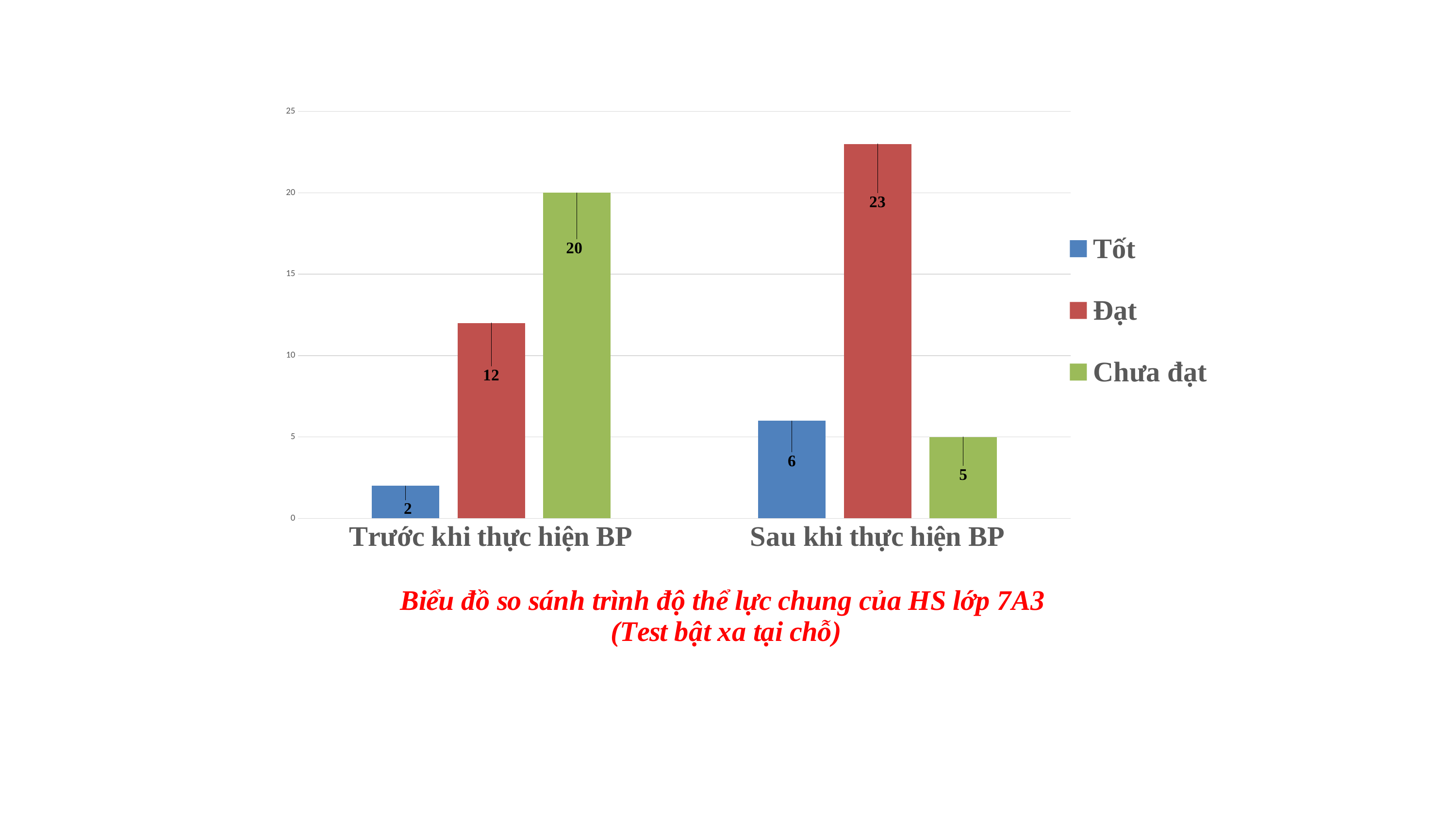
What is the value for Chưa đạt in the Trước khi thực hiện BP category? 20 What is the value for Tốt in the Sau khi thực hiện BP category? 6 How many categories are shown on the x axis? 2 What is the value for Đạt in the Sau khi thực hiện BP category? 23 What kind of chart is shown on the slide? Bar chart Which series has the highest value in the Sau khi thực hiện BP category? Đạt Which series has the lowest value in the Trước khi thực hiện BP category? Tốt What is the value for Tốt in the Trước khi thực hiện BP category? 2 How many series does the legend list? 3 What is the difference between the Đạt values for Sau khi thực hiện BP and Trước khi thực hiện BP? 11 Which colour represents the Chưa đạt series? Green Which is larger: Chưa đạt for Trước khi thực hiện BP or Chưa đạt for Sau khi thực hiện BP? Trước khi thực hiện BP